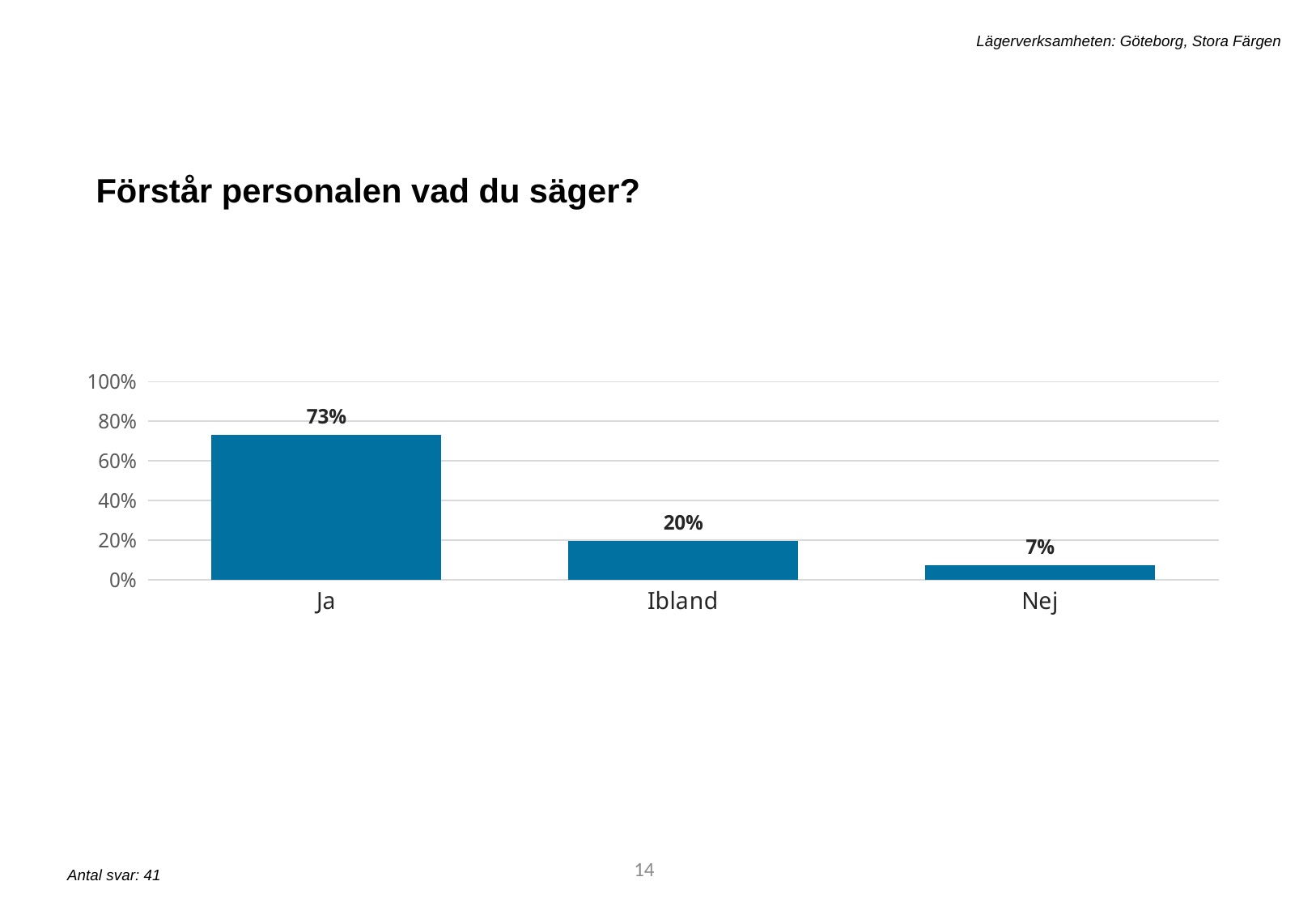
What is the value for Ibland? 20% Which category has the highest value? Ja What kind of chart is shown on the slide? bar chart What is the value for Nej? 7% Which is larger, the value for Ibland or the value for Nej? Ibland What is the difference between the values for Ja and Ibland? 53% What is the value for Ja? 73% Which category has the lowest value? Nej How many categories are shown on the x axis? 3 What is the title of the chart? Förstår personalen vad du säger? What is the difference between the values for Ibland and Nej? 13% Is the value for Ja greater or less than 60%? greater